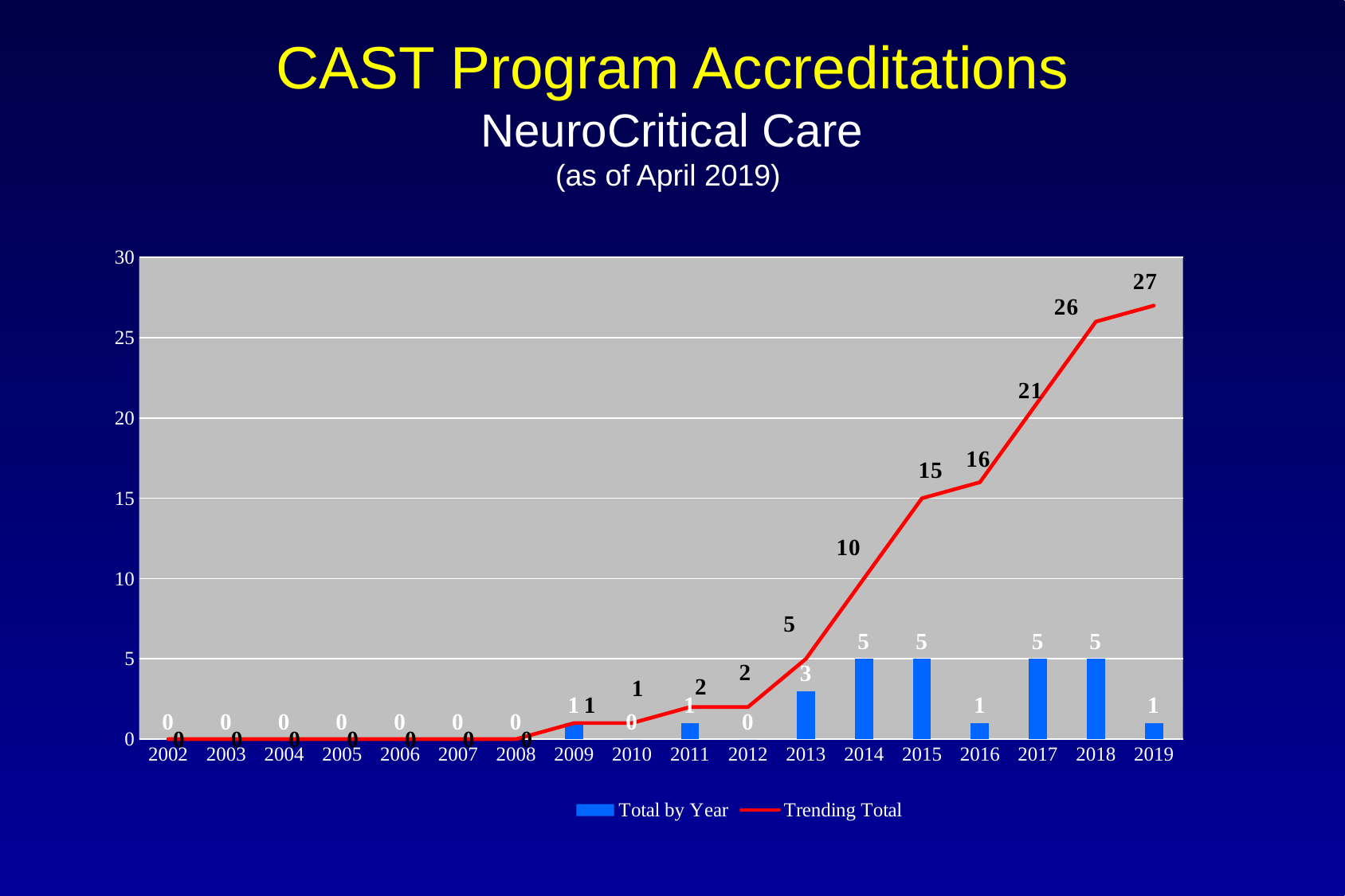
Is the Trending Total value for 2017 greater or less than 20? greater Does the Trending Total line rise or fall from 2012 to 2019? rise What is the Total by Year value for 2016? 1 In which year does the Trending Total line reach its highest value? 2019 What is the Total by Year value for 2013? 3 How many series does the legend list? 2 What colour are the Total by Year bars? Blue Which is larger, the Total by Year value for 2014 or for 2016? 2014 How many years are shown on the x axis? 18 What is the Trending Total value for 2014? 10 What is the difference between the Trending Total values for 2018 and 2017? 5 What is the Trending Total value for 2019? 27